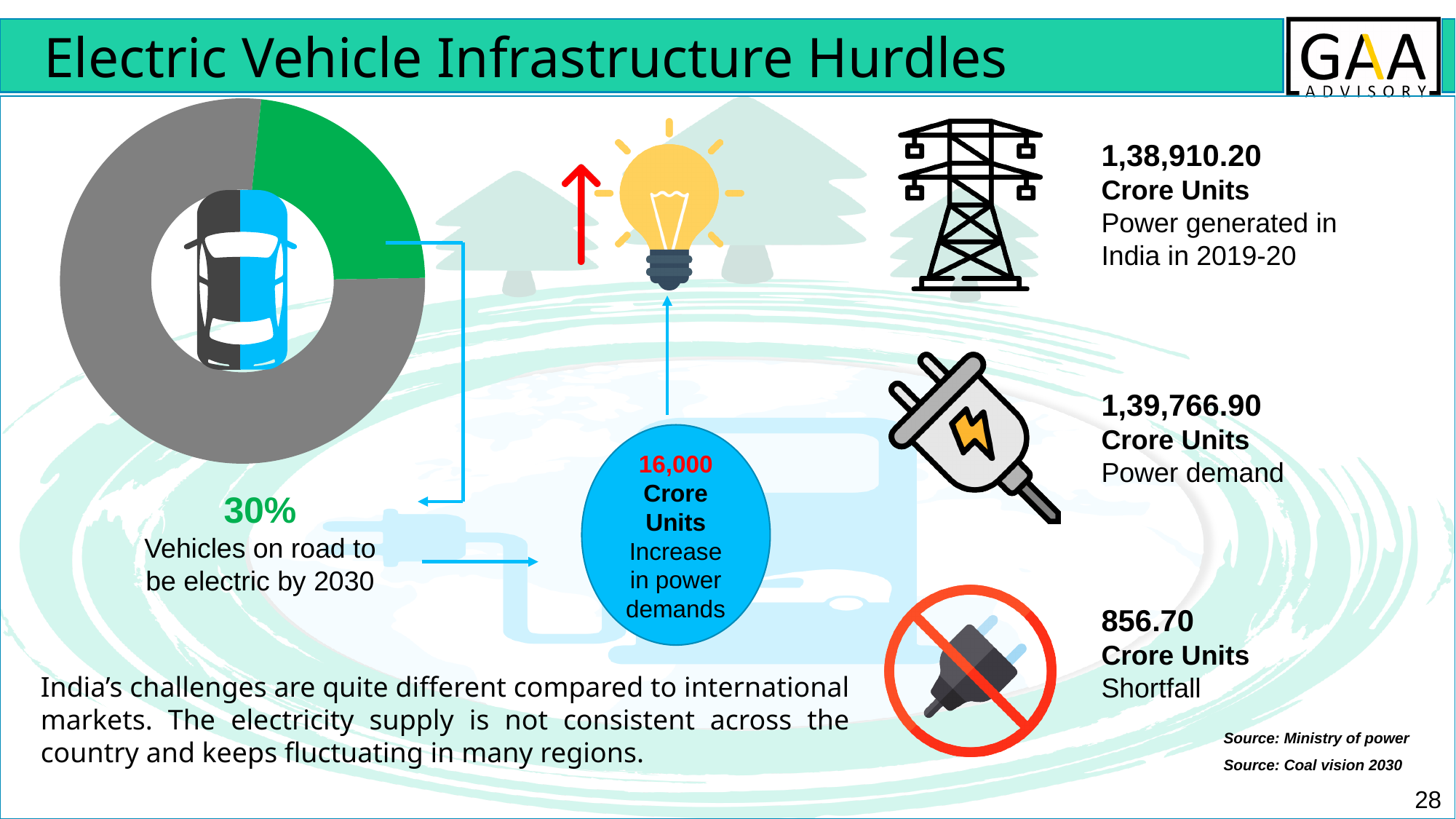
Which slice of the donut chart is larger, the green one or the grey one? The grey one What kind of chart is shown on the left of the slide? Donut chart What icon is shown in the centre of the donut chart? A car How many slices does the donut chart have? 2 What colour is the slice labelled 30% in the donut chart? Green What does the 30% slice of the donut chart represent? Vehicles on road to be electric by 2030 What share of the donut chart is highlighted in green? 30%